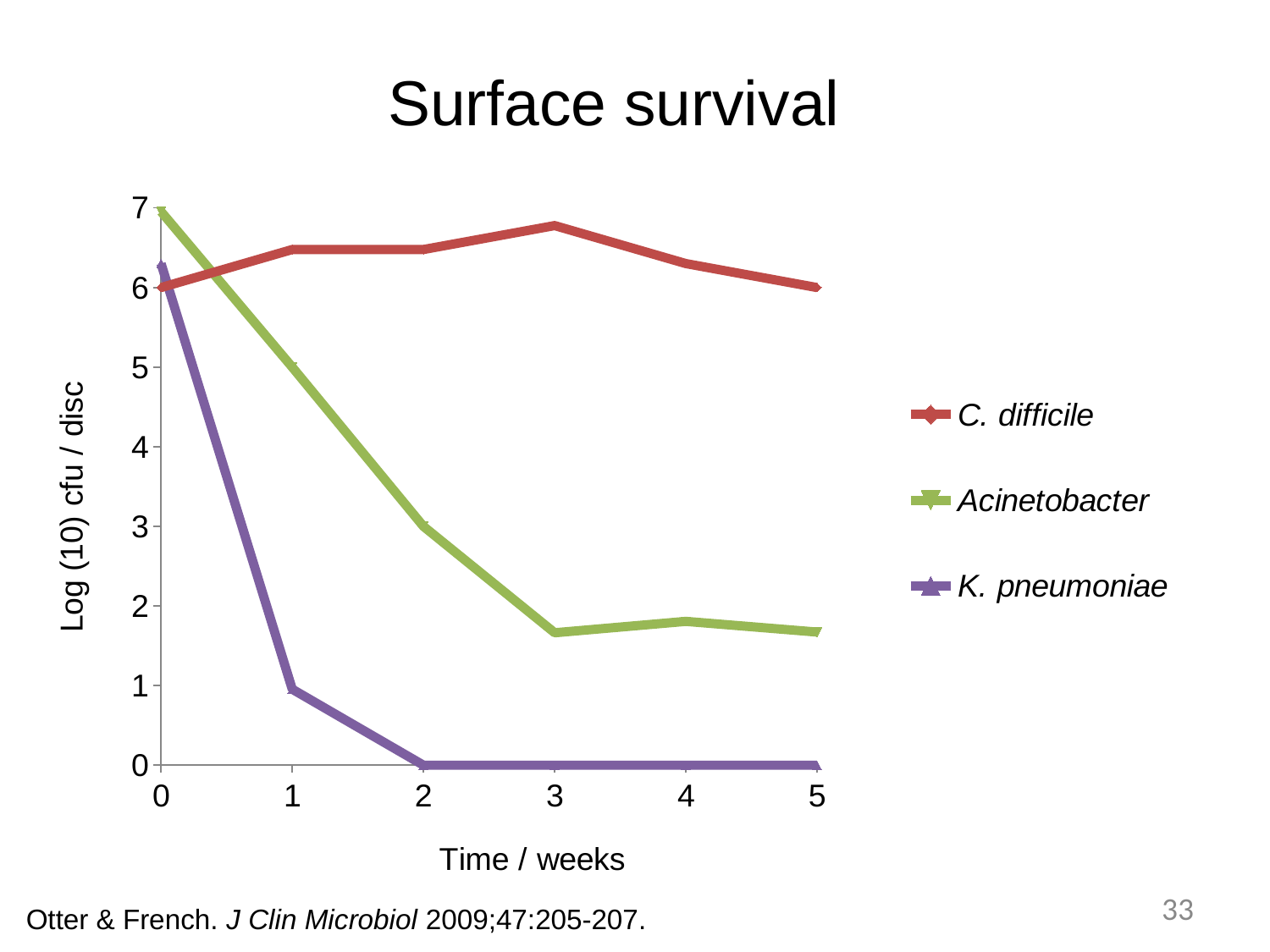
At week 5, which is larger: C. difficile or Acinetobacter? C. difficile What is the title of the y axis? Log (10) cfu / disc What is the value for K. pneumoniae at week 5? 0 Which series has the highest value at week 0? Acinetobacter What kind of chart is shown on the slide? line chart How many series does the legend list? 3 What is the value for C. difficile at week 0? 6 Does the Acinetobacter line rise or fall from week 0 to week 3? fall Is the value for C. difficile at week 3 greater or less than 6? greater How many time points are plotted along the x axis? 6